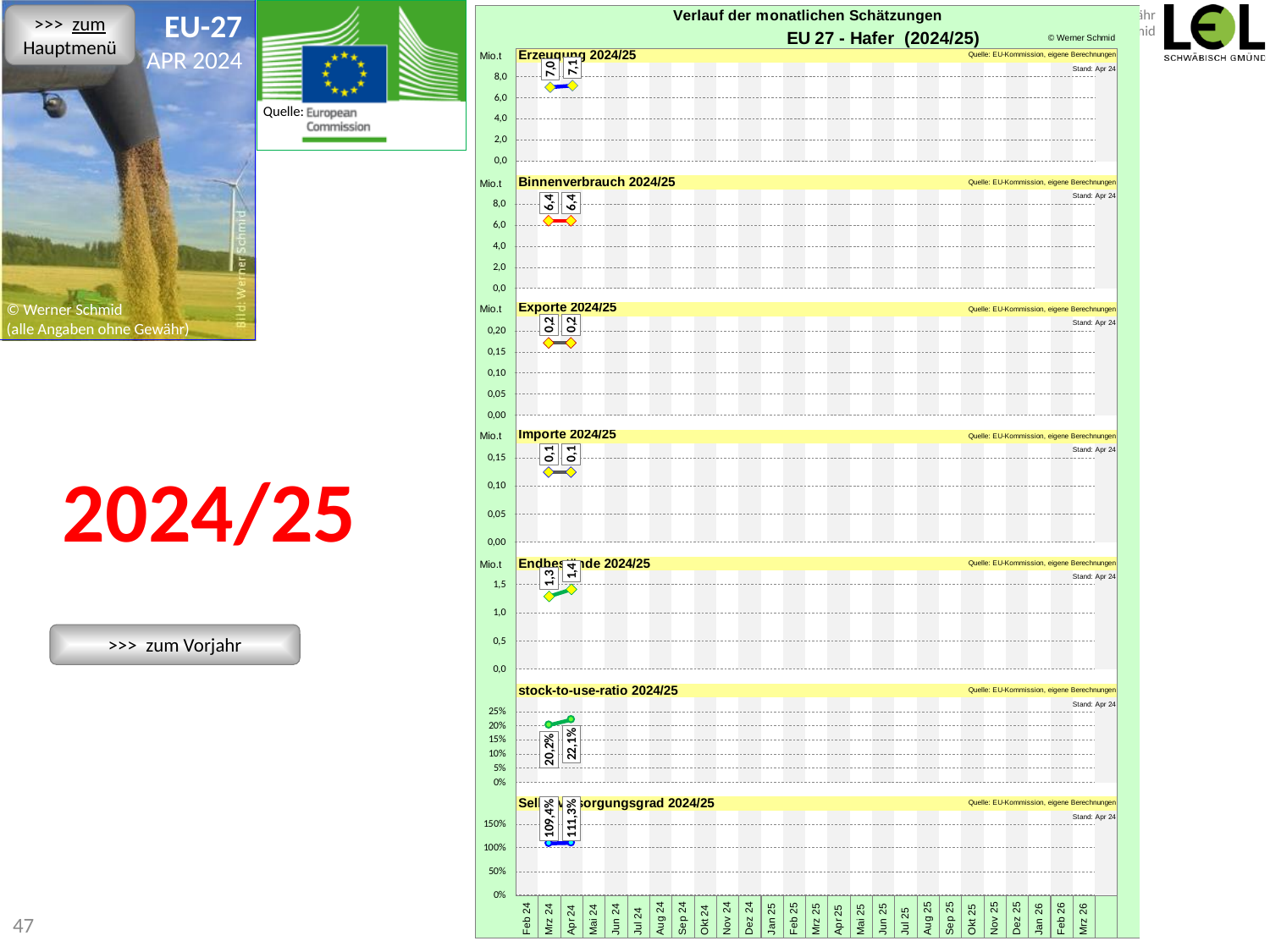
In the 'Exporte 2024/25' chart, what is the value for Mrz 24? 0,2 In the 'Endbestände 2024/25' chart, what is the value for Apr 24? 1,4 In the 'Erzeugung 2024/25' chart, do the values rise or fall from Mrz 24 to Apr 24? rise In the 'Erzeugung 2024/25' chart, what is the value for Mrz 24? 7,0 In the 'Selbstversorgungsgrad 2024/25' chart, what is the value for Mrz 24? 109,4% What type of chart is the 'Selbstversorgungsgrad 2024/25' chart? line chart In the 'stock-to-use-ratio 2024/25' chart, what is the difference between the Apr 24 and Mrz 24 values? 1,9 percentage points In the 'Binnenverbrauch 2024/25' chart, what is the value for Apr 24? 6,4 How many data points are plotted in the 'Endbestände 2024/25' chart? 2 In the 'stock-to-use-ratio 2024/25' chart, what is the value for Apr 24? 22,1% In the 'Importe 2024/25' chart, what is the value for Apr 24? 0,1 In the 'Erzeugung 2024/25' chart, what is the value for Apr 24? 7,1